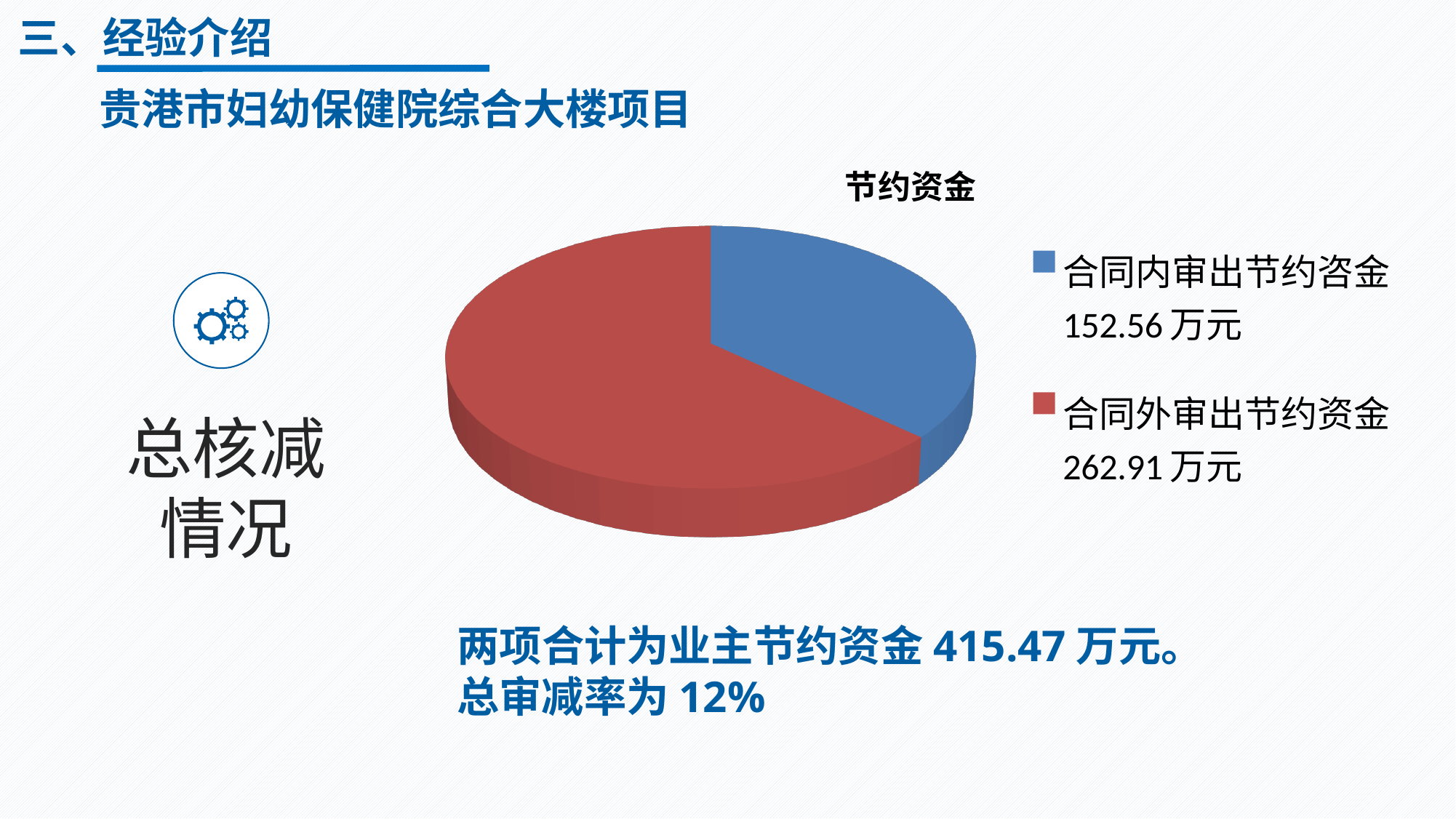
What colour is the slice for 合同外审出节约资金? Red What share of the pie does 合同外审出节约资金 represent? 63.3% What is the total of the two categories in the pie chart? 415.47 万元 What is the title of the chart? 节约资金 What is the value for 合同外审出节约资金? 262.91 万元 How many slices does the pie chart have? 2 What is the value for 合同内审出节约资金? 152.56 万元 Which category has the largest slice of the pie? 合同外审出节约资金 Which is larger, 合同内审出节约资金 or 合同外审出节约资金? 合同外审出节约资金 What is the difference between 合同外审出节约资金 and 合同内审出节约资金? 110.35 万元 Which category has the smallest slice of the pie? 合同内审出节约资金 What type of chart is shown on the slide? Pie chart